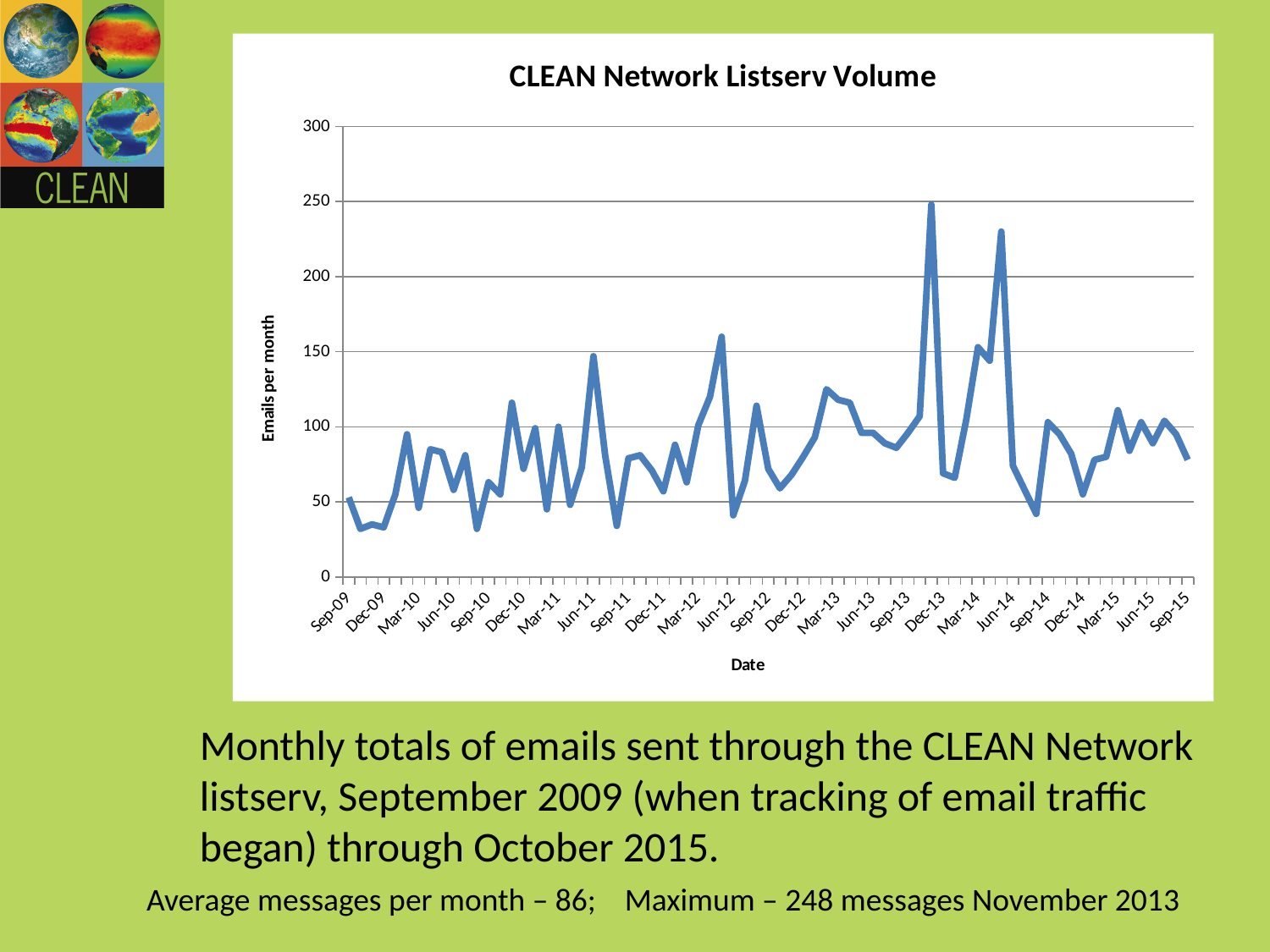
What is the label on the vertical axis of the chart? Emails per month Is the value for Dec-09 greater or less than 50? less Is the value for Mar-13 greater or less than 100? greater Is the value for Jun-14 greater or less than 200? less According to the slide, what is the maximum monthly number of messages shown in the chart? 248 In which month did the listserv volume reach its maximum? November 2013 What kind of chart is shown on the slide? line chart What is the title of the chart? CLEAN Network Listserv Volume Which is larger, the value for Jun-14 or the value for Sep-14? Sep-14